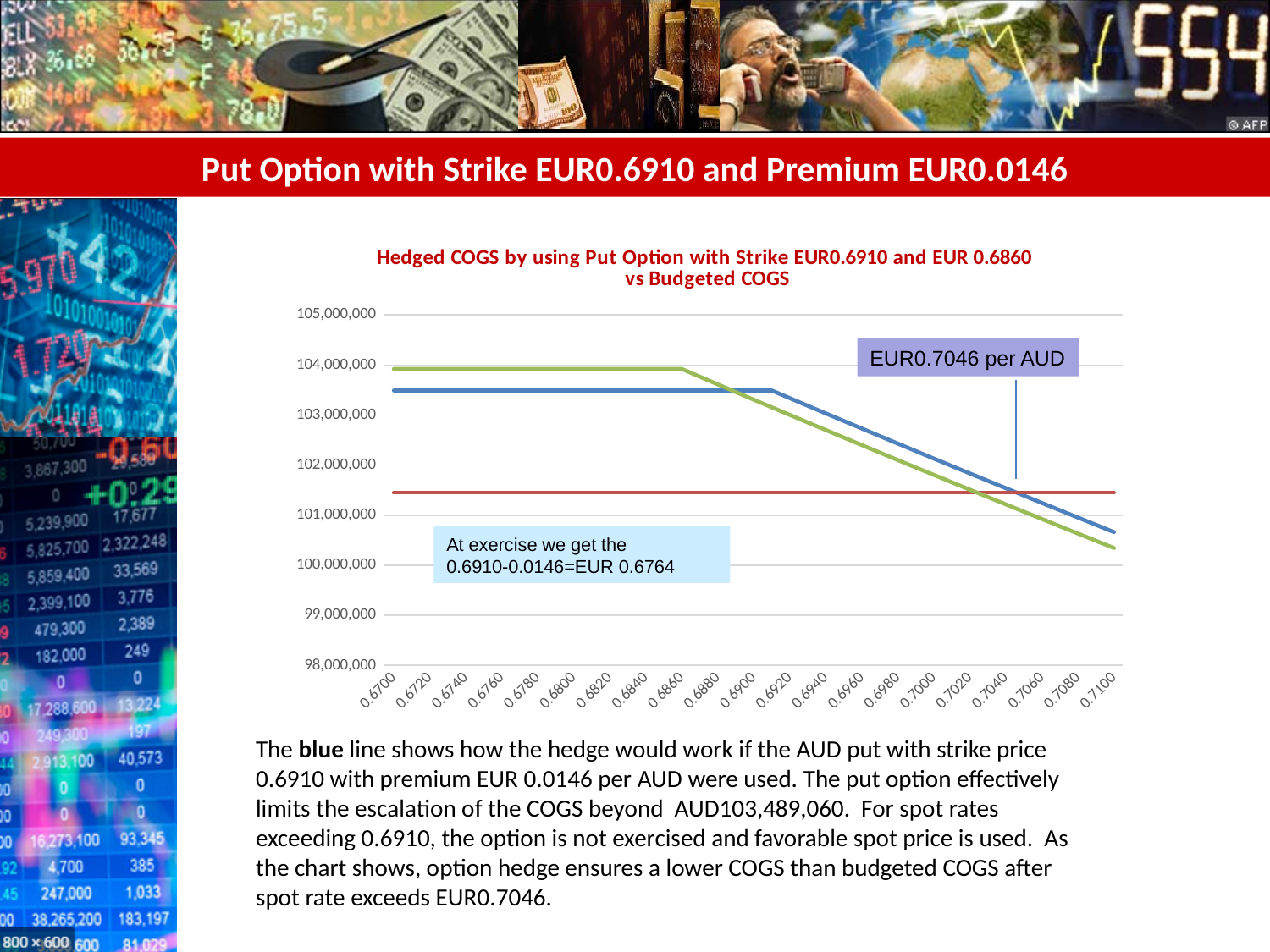
What kind of chart is shown on the slide? line chart Is the value of the blue line at 0.6700 greater or less than 103,000,000? greater Is the value of the blue line at 0.7100 greater or less than 101,000,000? less At a spot rate of 0.7100, which line is higher, the blue line or the green line? blue line What is the title of the chart? Hedged COGS by using Put Option with Strike EUR0.6910 and EUR 0.6860 vs Budgeted COGS How many spot-rate values are labelled along the x axis of the chart? 21 Is the value of the green line at 0.7100 greater or less than 101,000,000? less What spot rate does the annotation box above the red line's crossing point state? EUR0.7046 per AUD At a spot rate of 0.6700, which line is higher, the blue line or the green line? green line Does the blue line rise or fall as the spot rate moves from 0.6920 to 0.7100? fall